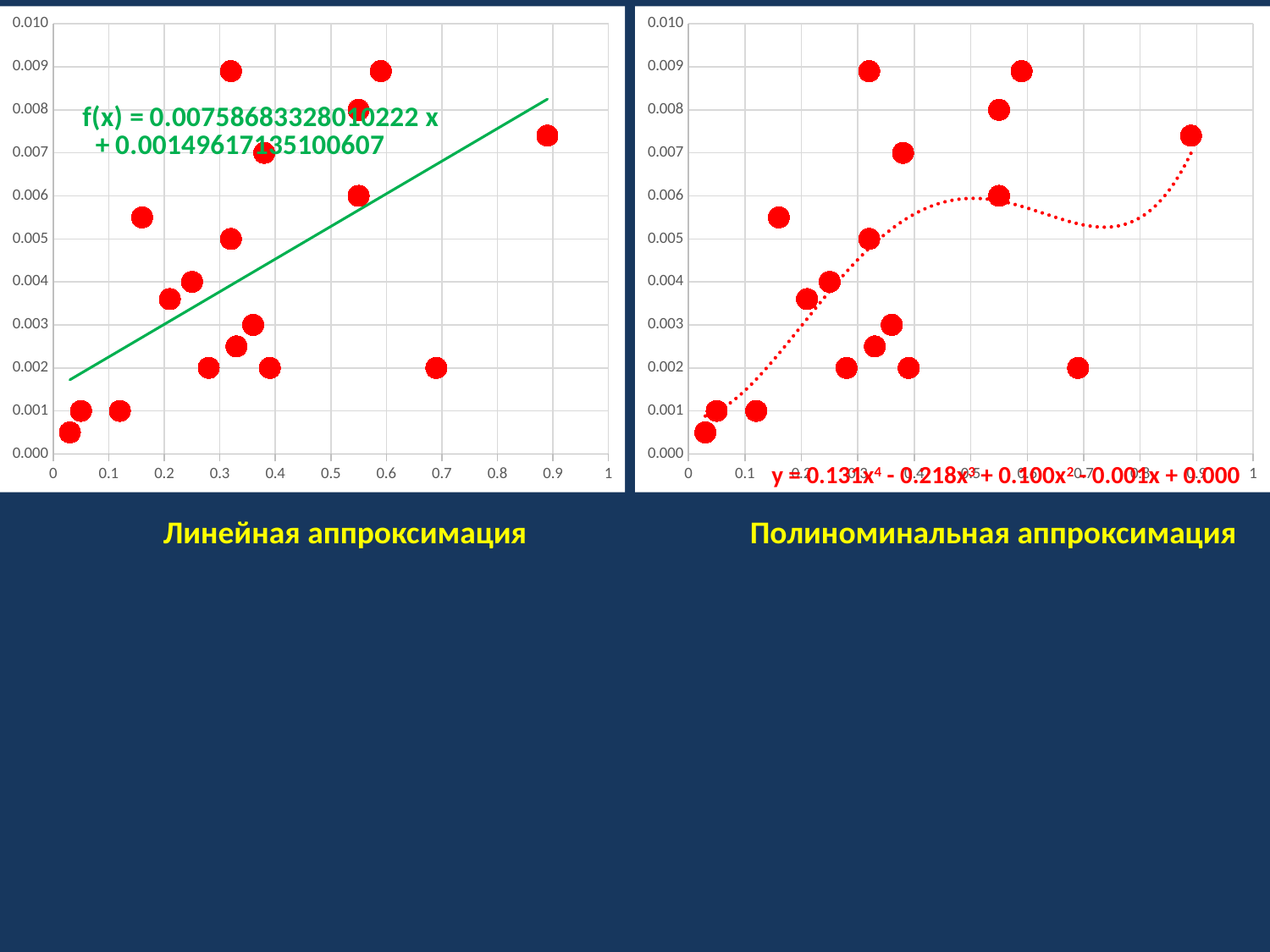
On the right chart, is the y value of the point near x = 0.55 that lies on the 0.008 gridline greater or less than 0.007? greater On the right chart, is the y value of the point near x = 0.7 greater or less than 0.003? less What is the maximum value shown on the y axis of the left chart? 0.010 On the left chart, which point is higher: the one near x = 0.16 or the one near x = 0.12? the one near x = 0.16 On the left chart, is the y value of the lowest point greater or less than 0.001? less On the left chart, does the green trend line rise or fall as x increases? rises What is the caption under the right chart? Полиноминальная аппроксимация What kind of chart is shown on the left side of the slide? scatter chart